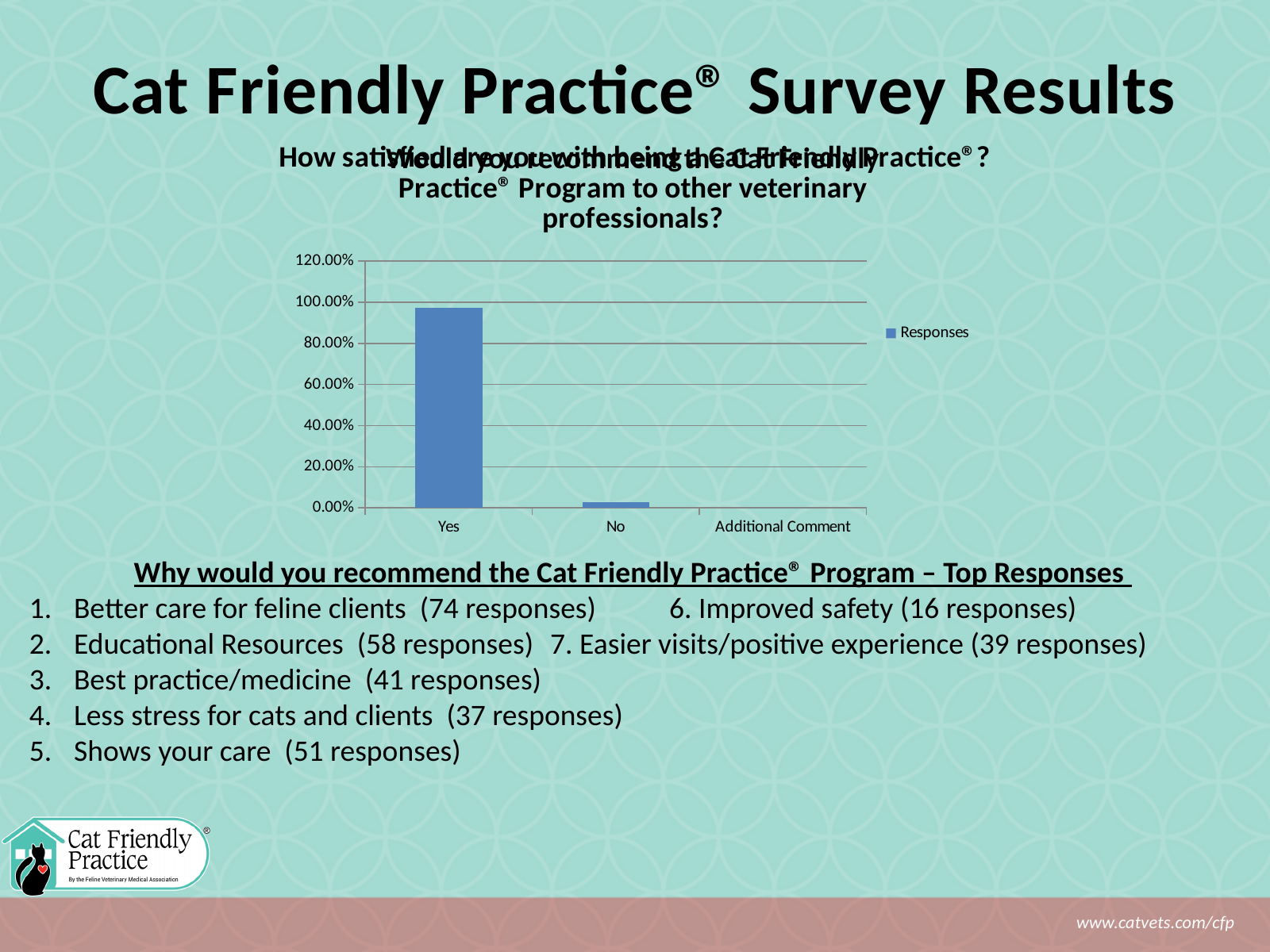
What is the name of the series listed in the chart's legend? Responses Which is larger, the value for Yes or the value for No? Yes How many series does the chart's legend list? 1 How many categories are shown on the x axis of the chart? 3 What kind of chart is shown on the slide? bar chart Do the values fall or rise moving from Yes to No along the x axis? fall Is the value for Yes greater or less than 80.00%? greater Which category has the highest value in the chart? Yes What is the highest tick value shown on the chart's y axis? 120.00% Is the value for No greater or less than 20.00%? less Is the value for Yes greater or less than 100.00%? less